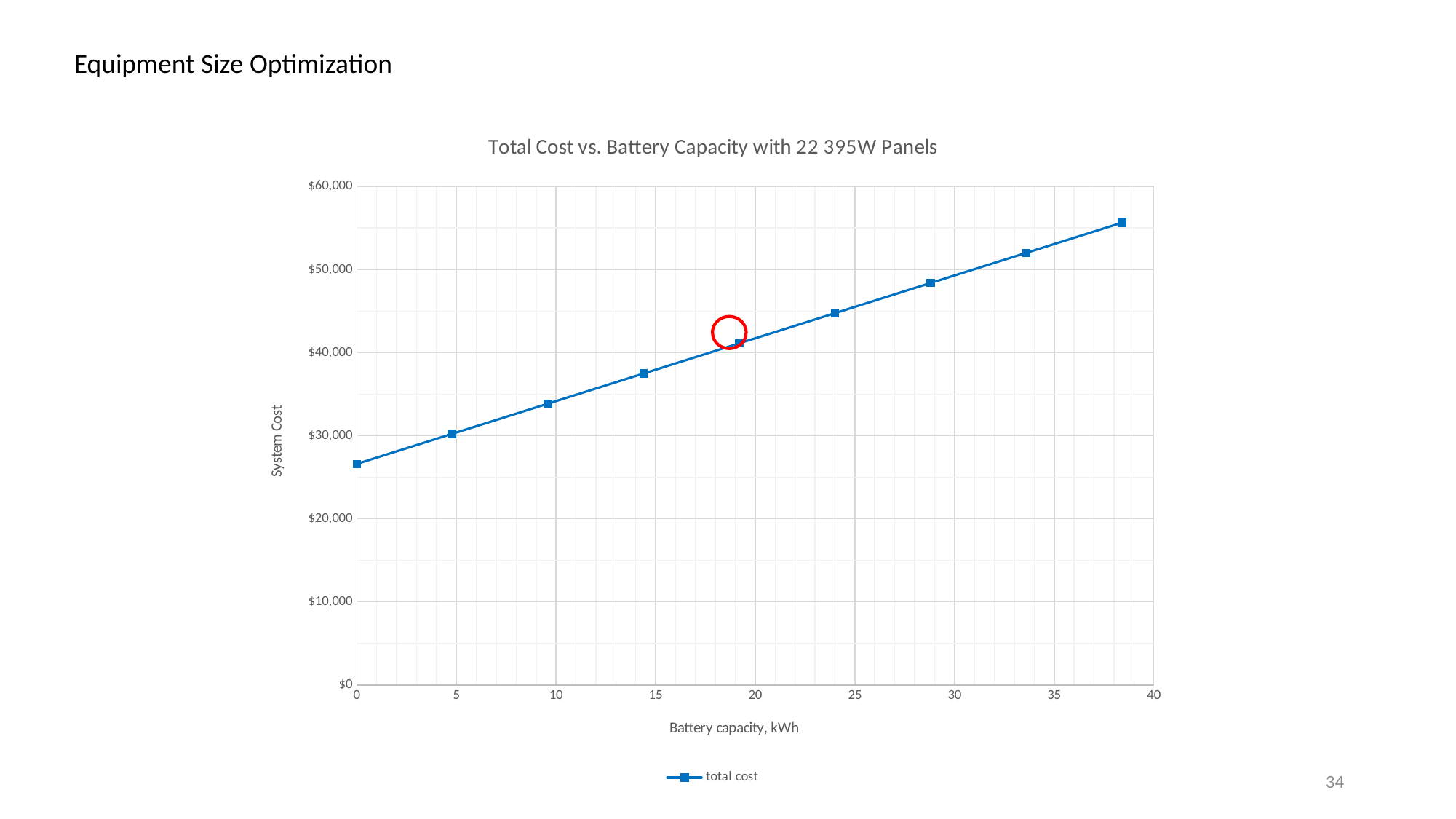
What is the name of the series shown in the legend? total cost Is the total cost at 0 kWh battery capacity greater or less than $20,000? greater What is the title of the chart? Total Cost vs. Battery Capacity with 22 395W Panels Is the total cost at 0 kWh battery capacity greater or less than $30,000? less How many data points are plotted on the line? 9 Is the total cost at the rightmost data point greater or less than $50,000? greater How many series does the legend list? 1 What kind of chart is shown on the slide? line chart Which data point has the highest total cost, the leftmost or the rightmost? the rightmost Does the total cost rise or fall as battery capacity increases? rises